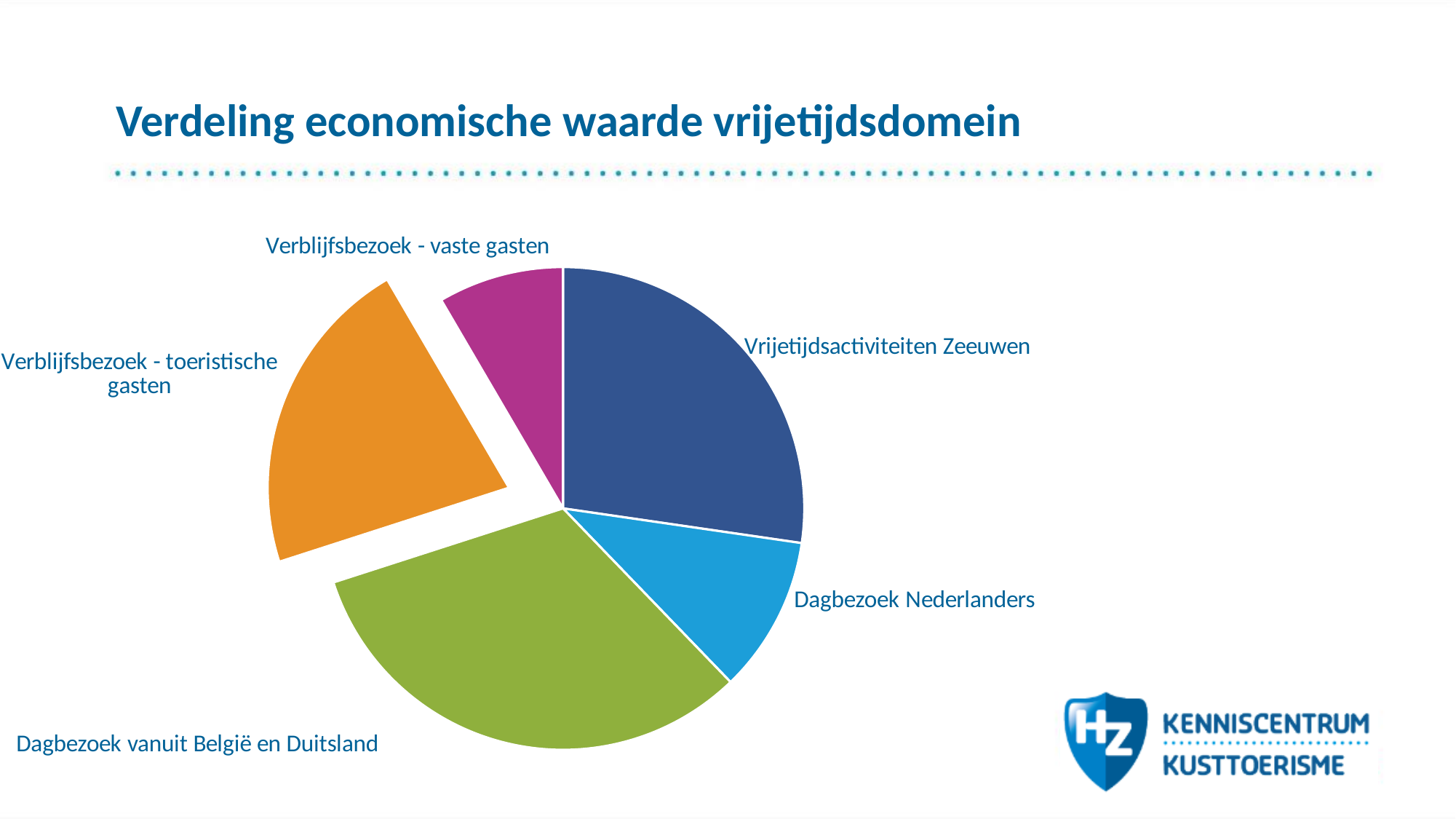
Which slice is larger: Dagbezoek vanuit België en Duitsland or Dagbezoek Nederlanders? Dagbezoek vanuit België en Duitsland What kind of chart is shown on the slide? pie chart Which slice is larger: Dagbezoek vanuit België en Duitsland or Verblijfsbezoek - vaste gasten? Dagbezoek vanuit België en Duitsland Which slice is larger: Verblijfsbezoek - toeristische gasten or Dagbezoek Nederlanders? Verblijfsbezoek - toeristische gasten How many slices does the pie chart have? 5 Which slice of the pie chart is pulled out (exploded) from the rest of the pie? Verblijfsbezoek - toeristische gasten What is the title of the chart on the slide? Verdeling economische waarde vrijetijdsdomein